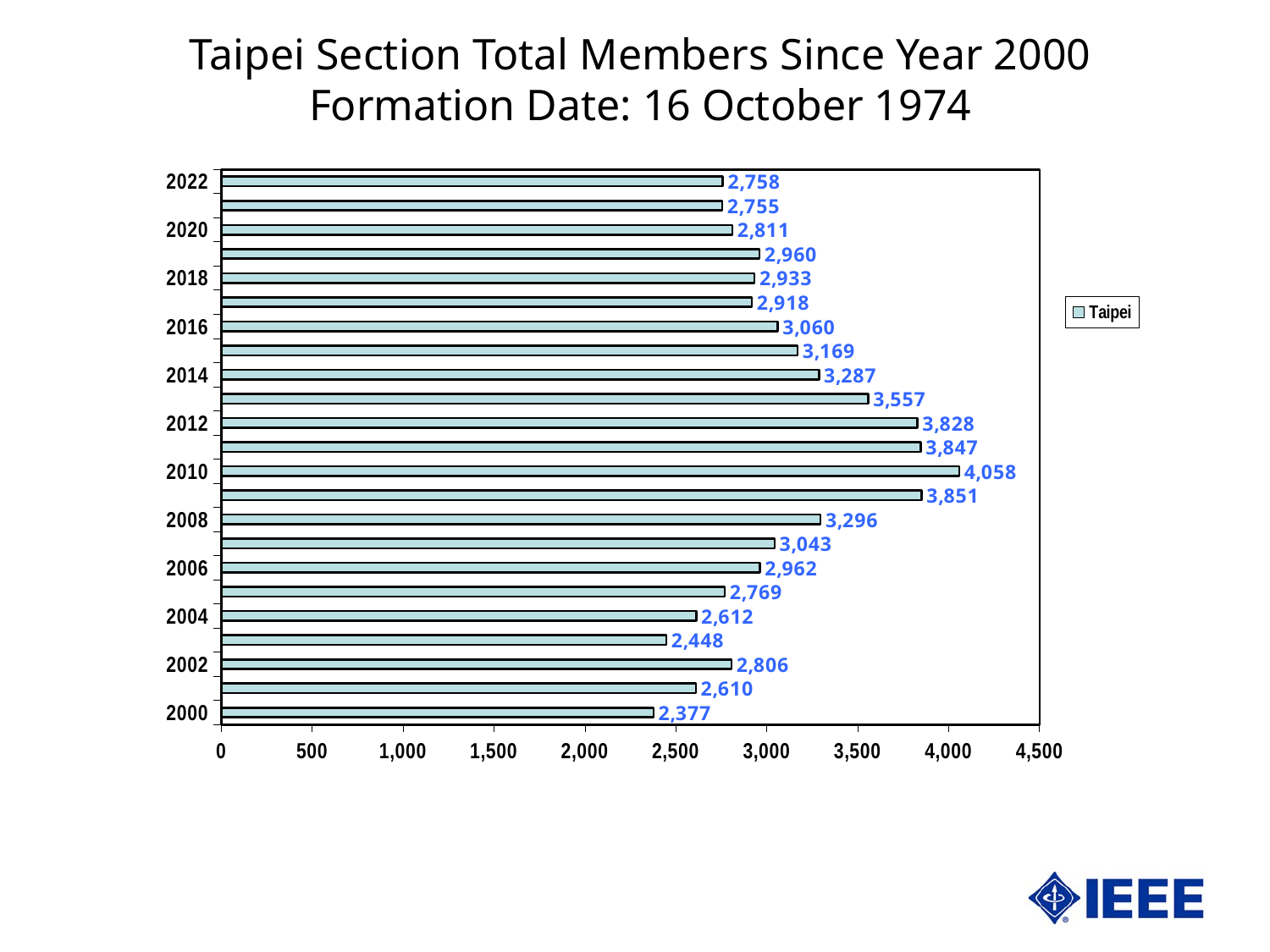
What series name does the legend show? Taipei Which is larger, the value for 2012 or the value for 2014? 2012 What is the value for 2022? 2,758 What is the value for 2010? 4,058 Which year has the highest value? 2010 What is the difference between the values for 2008 and 2006? 334 Which year has the lowest value? 2000 How many bars are plotted in the chart? 23 What is the value for 2016? 3,060 What is the difference between the values for 2010 and 2000? 1,681 What kind of chart is shown? Bar chart What is the value for 2000? 2,377